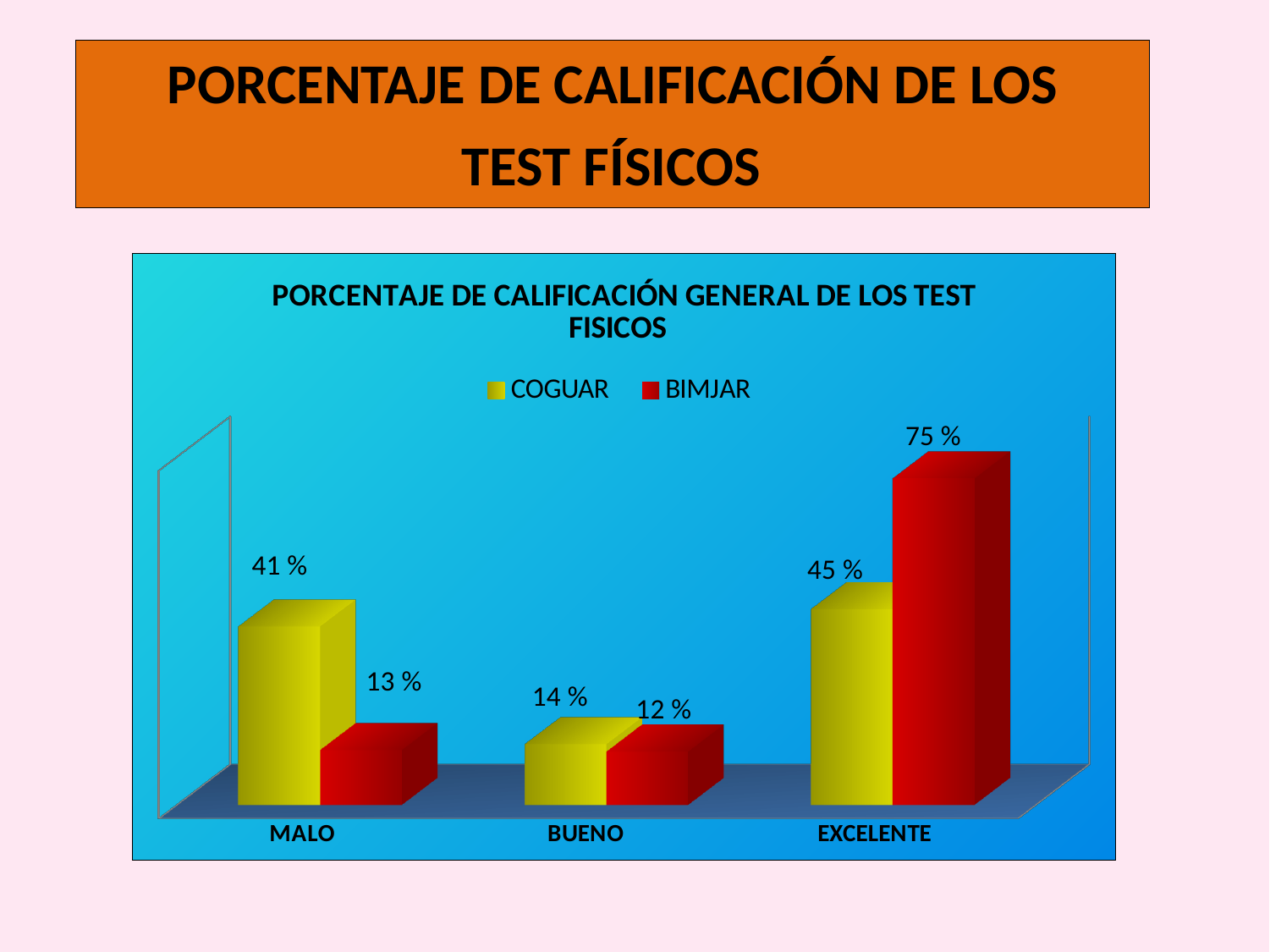
What is the value for COGUAR in the EXCELENTE category? 45 % What is the value for BIMJAR in the BUENO category? 12 % How many series does the legend list? 2 Which category has the lowest value for COGUAR? BUENO What kind of chart is shown on the slide? Bar chart Which category has the highest value for BIMJAR? EXCELENTE What colour represents the BIMJAR series? Red What is the value for COGUAR in the MALO category? 41 % How many categories are shown on the x axis? 3 What is the value for BIMJAR in the EXCELENTE category? 75 % What is the difference between the BIMJAR and COGUAR values in the EXCELENTE category? 30 % Which is larger in the MALO category, COGUAR or BIMJAR? COGUAR